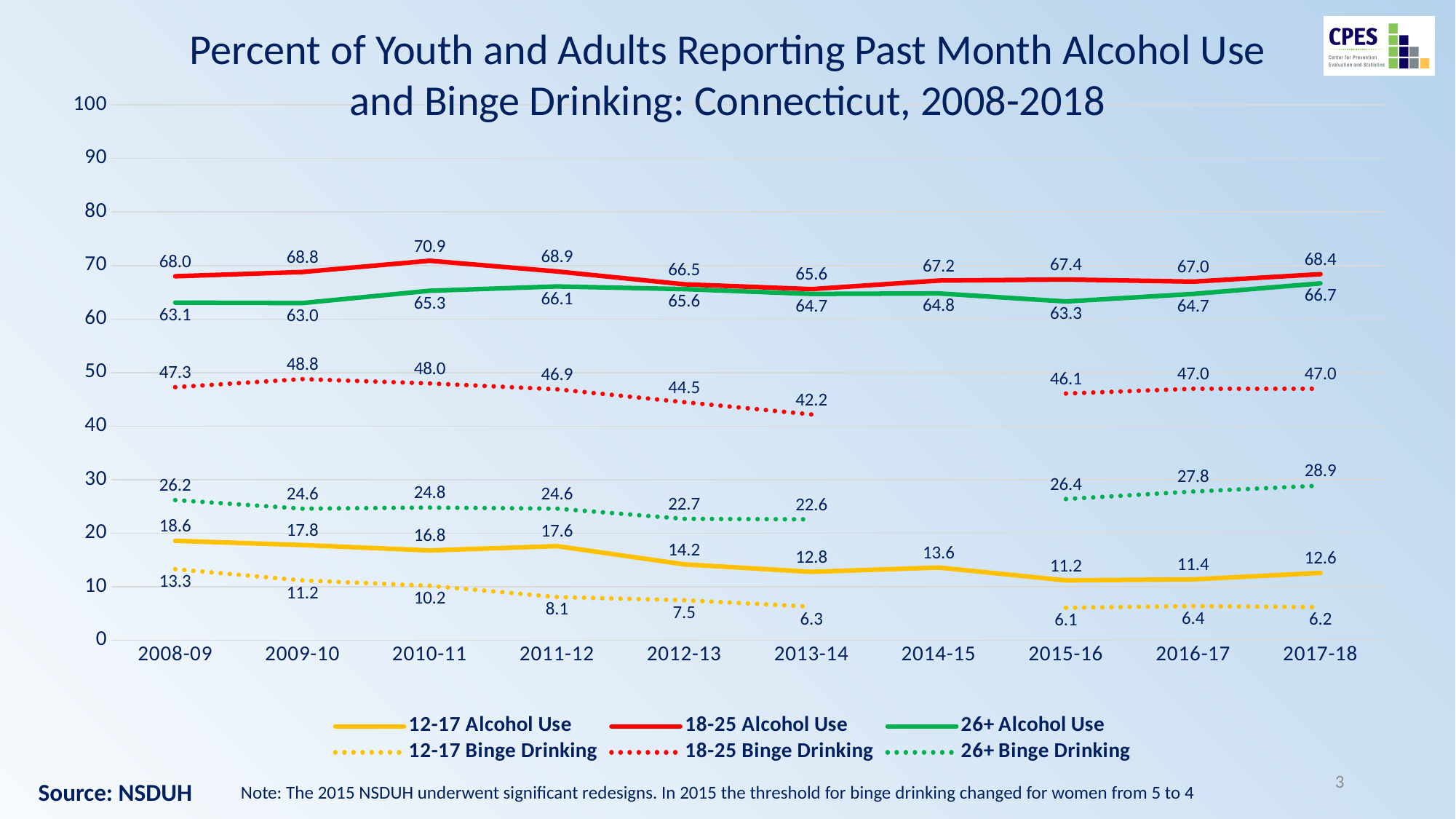
What is the value for 12-17 Binge Drinking in 2008-09? 13.3 What is the value for 26+ Alcohol Use in 2017-18? 66.7 How many series does the legend list? 6 What is the value for 18-25 Alcohol Use in 2010-11? 70.9 What is the difference between 18-25 Alcohol Use and 26+ Alcohol Use in 2008-09? 4.9 In which period is 18-25 Alcohol Use highest? 2010-11 How many periods are shown on the x axis? 10 What kind of chart is shown on the slide? Line chart Does 12-17 Binge Drinking rise or fall from 2008-09 to 2013-14? Fall Which series is drawn as a dotted red line? 18-25 Binge Drinking In which period is 12-17 Alcohol Use lowest? 2015-16 Which is larger in 2013-14: 18-25 Binge Drinking or 26+ Binge Drinking? 18-25 Binge Drinking